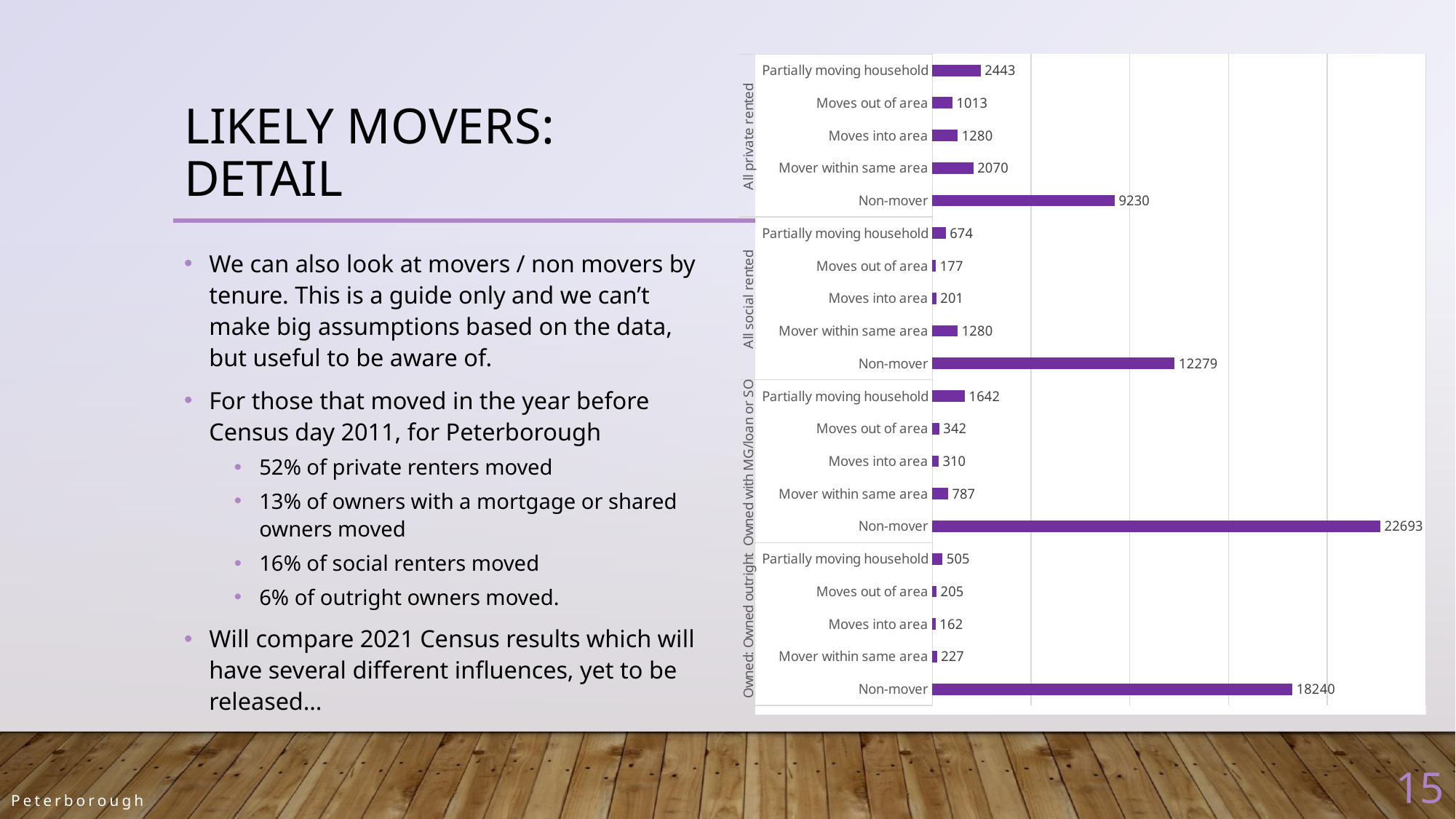
What is the difference between Non-mover in the Owned with MG/loan or SO group and Non-mover in the Owned outright group? 4453 What is the value for Mover within same area in the Owned outright group? 227 How many bars are plotted on the chart in total? 20 What is the value for Partially moving household in the All social rented group? 674 How many tenure groups are shown on the chart's vertical axis? 4 What is the difference between Non-mover and Mover within same area in the All private rented group? 7160 Which bar has the highest value on the chart? Non-mover (Owned with MG/loan or SO), 22693 What is the value for Non-mover in the All private rented group? 9230 Which is larger: Moves into area in All private rented or Moves into area in All social rented? All private rented Which category has the lowest value in the Owned outright group? Moves into area What kind of chart is shown on the slide? bar chart What is the value for Moves out of area in the Owned with MG/loan or SO group? 342